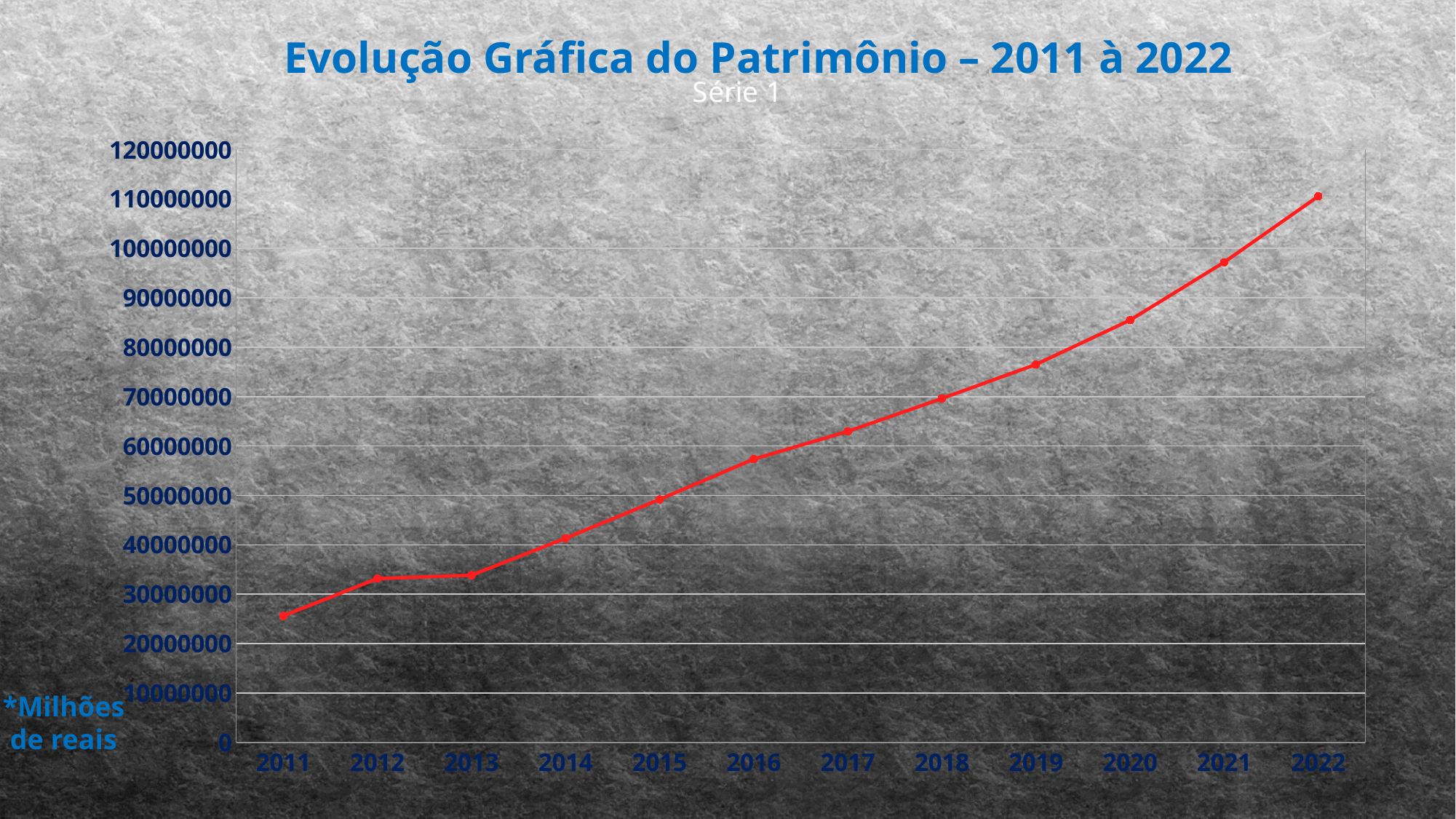
Is the value for 2011 greater or less than 30000000? less Which year has the lowest value on the chart? 2011 Is the value for 2019 greater or less than 70000000? greater Is the value for 2016 greater or less than 60000000? less What is the title of the chart? Evolução Gráfica do Patrimônio – 2011 à 2022 What type of chart is shown on the slide? line chart Which year has the larger value, 2018 or 2021? 2021 How many years are plotted on the x axis of the chart? 12 Do the values generally rise or fall from 2011 to 2022? rise Which year has the highest value on the chart? 2022